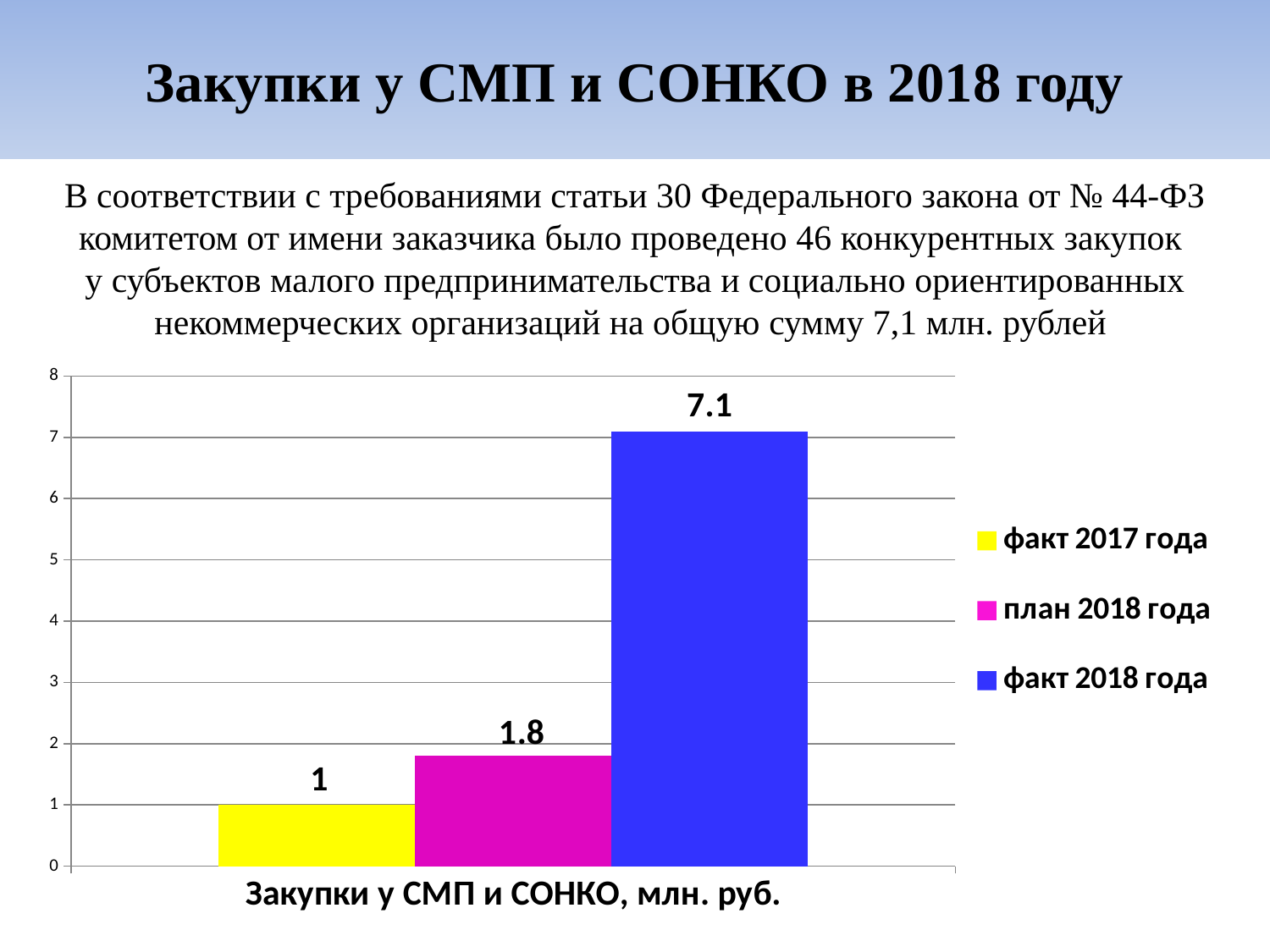
What is the value for план 2018 года? 1.8 What is the difference between факт 2018 года and план 2018 года? 5.3 What is the value for факт 2017 года? 1 What colour is the bar for факт 2018 года? blue Which is larger, план 2018 года or факт 2017 года? план 2018 года Which series has the highest value? факт 2018 года How many series does the legend list? 3 Which series has the lowest value? факт 2017 года Is the value for факт 2018 года greater or less than 7? greater What is the value for факт 2018 года? 7.1 What is the difference between план 2018 года and факт 2017 года? 0.8 What kind of chart is shown on the slide? bar chart